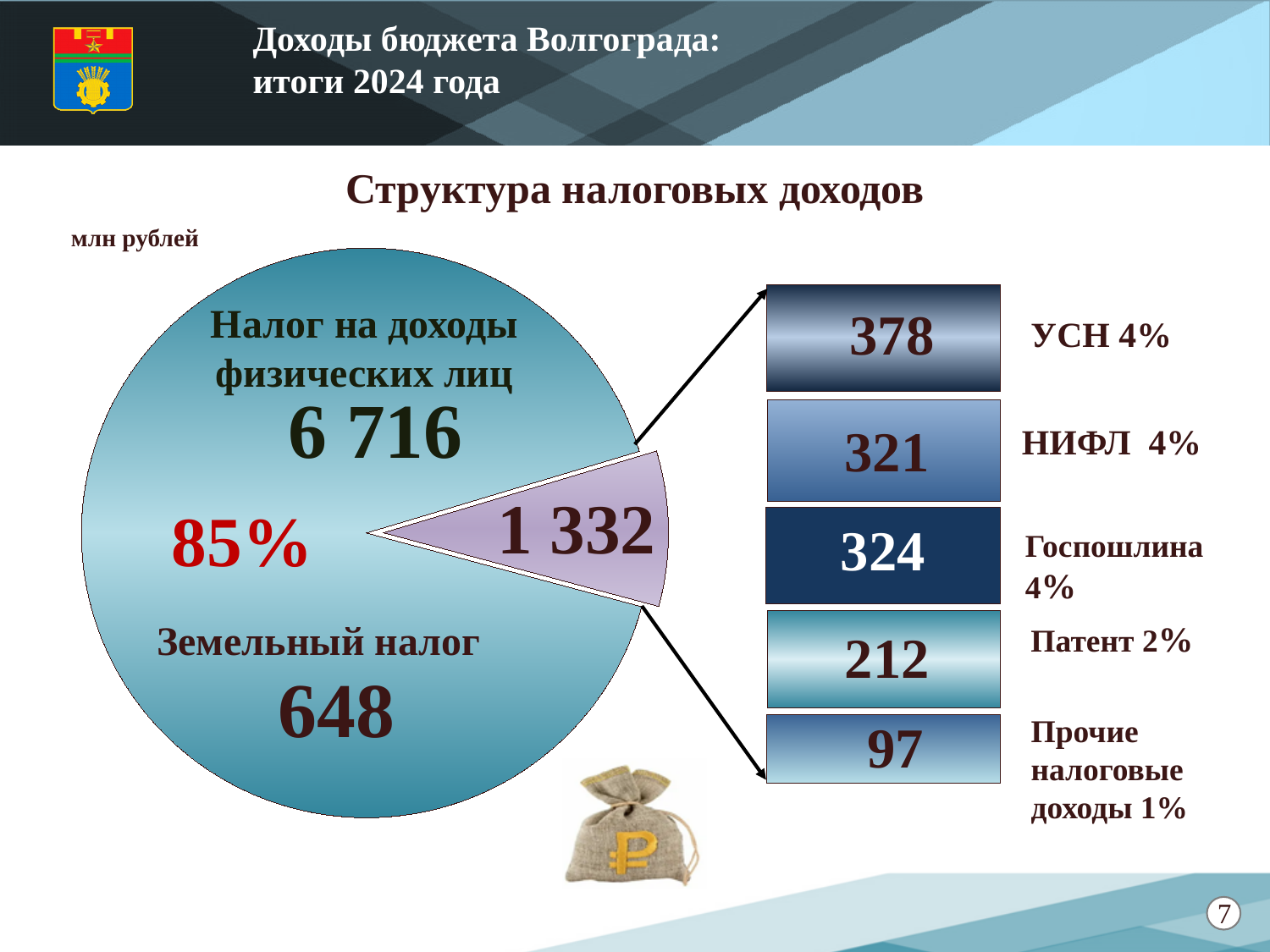
What value is shown for Патент? 212 What percentage is shown for "Прочие налоговые доходы"? 1% What is the value shown for "Налог на доходы физических лиц"? 6 716 What is the difference between the values for УСН and НИФЛ? 57 Which of the five items in the breakdown on the right has the highest value? УСН How many items are listed in the breakdown of the small slice on the right? 5 What is the value of the small pie slice that is broken down on the right? 1 332 What is the value shown for "Земельный налог"? 648 What kind of chart is shown under the title "Структура налоговых доходов"? pie chart What value is shown for УСН? 378 Which of the five items in the breakdown on the right has the lowest value? Прочие налоговые доходы What share of the pie does the large slice represent? 85%